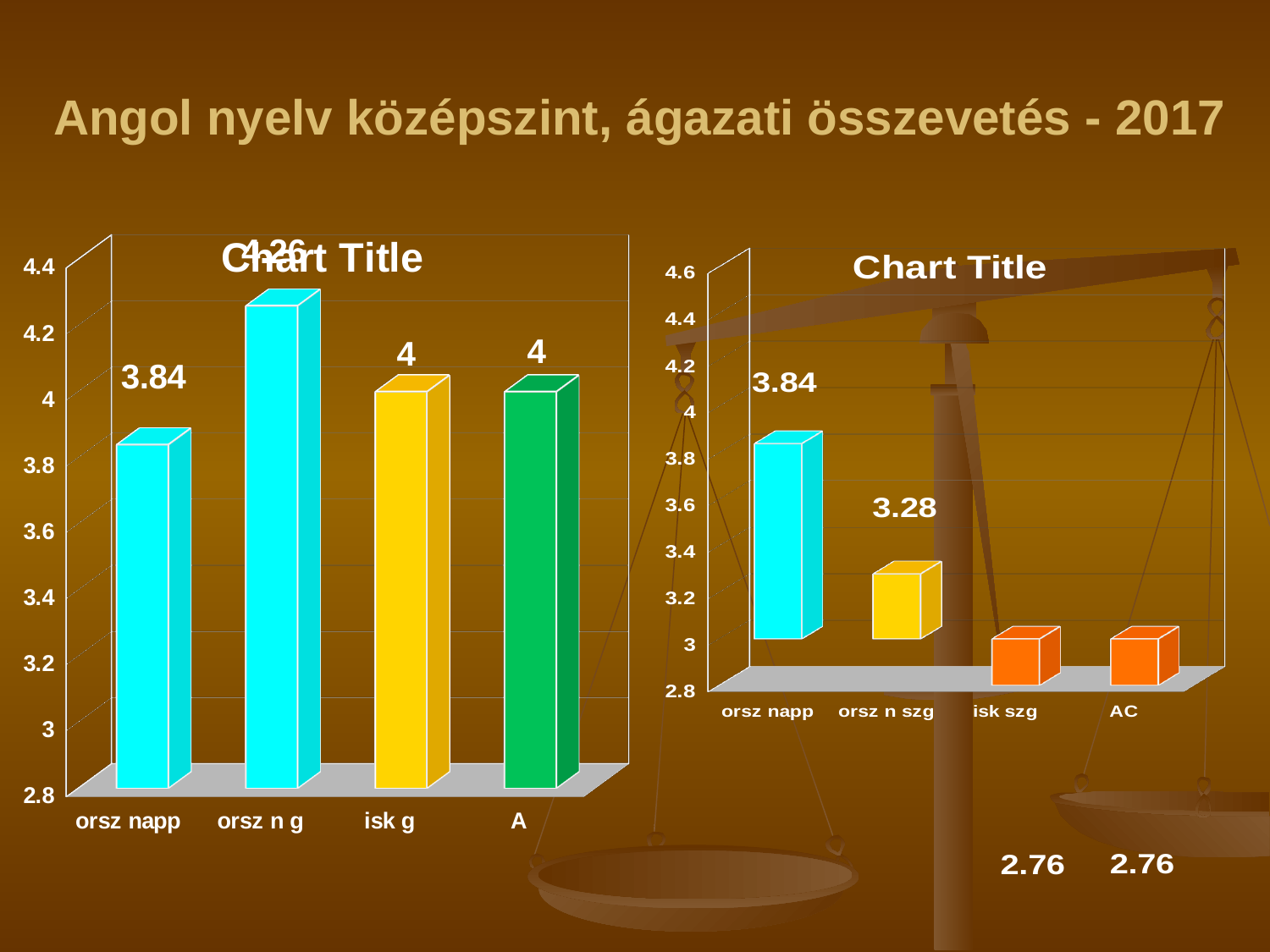
On the right chart, what is the value for orsz n szg? 3.28 On the right chart, what is the value for orsz napp? 3.84 On the left chart, what is the value for orsz napp? 3.84 On the right chart, which category has the highest value? orsz napp On the left chart, is the value for orsz n g greater or less than 4.2? greater On the right chart, what is the difference between the values for orsz napp and orsz n szg? 0.56 What kind of chart is the right chart? bar chart On the right chart, which is larger, the value for orsz n szg or the value for isk szg? orsz n szg On the left chart, which category has the lowest value? orsz napp On the left chart, which category has the highest value? orsz n g On the left chart, what is the value for isk g? 4 On the left chart, how many categories are shown? 4